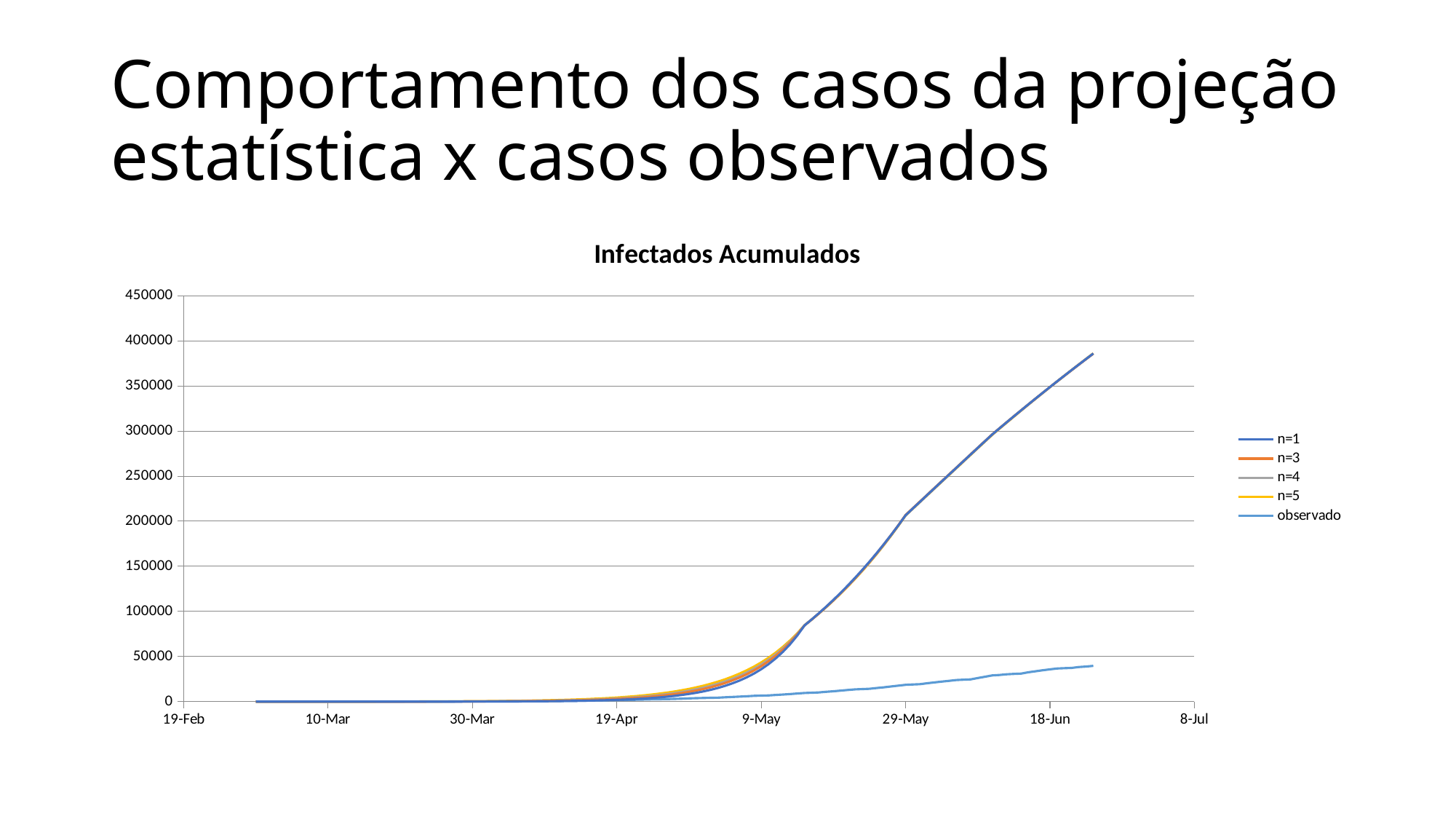
Which series has the lowest value at the end of the plotted period? observado Do the values of the observado series rise or fall along the x axis? rise How many series does the legend list? 5 Is the final value of the observado series greater or less than 50000? less Do the values of the n=1 series rise or fall along the x axis? rise Is the final value of the n=1 series greater or less than 400000? less What is the title of the chart? Infectados Acumulados Is the final value of the n=1 series greater or less than 350000? greater At the end of the plotted period, which is larger: the n=1 series or the observado series? n=1 Which series are listed in the legend? n=1, n=3, n=4, n=5, observado What kind of chart is shown on the slide? line chart